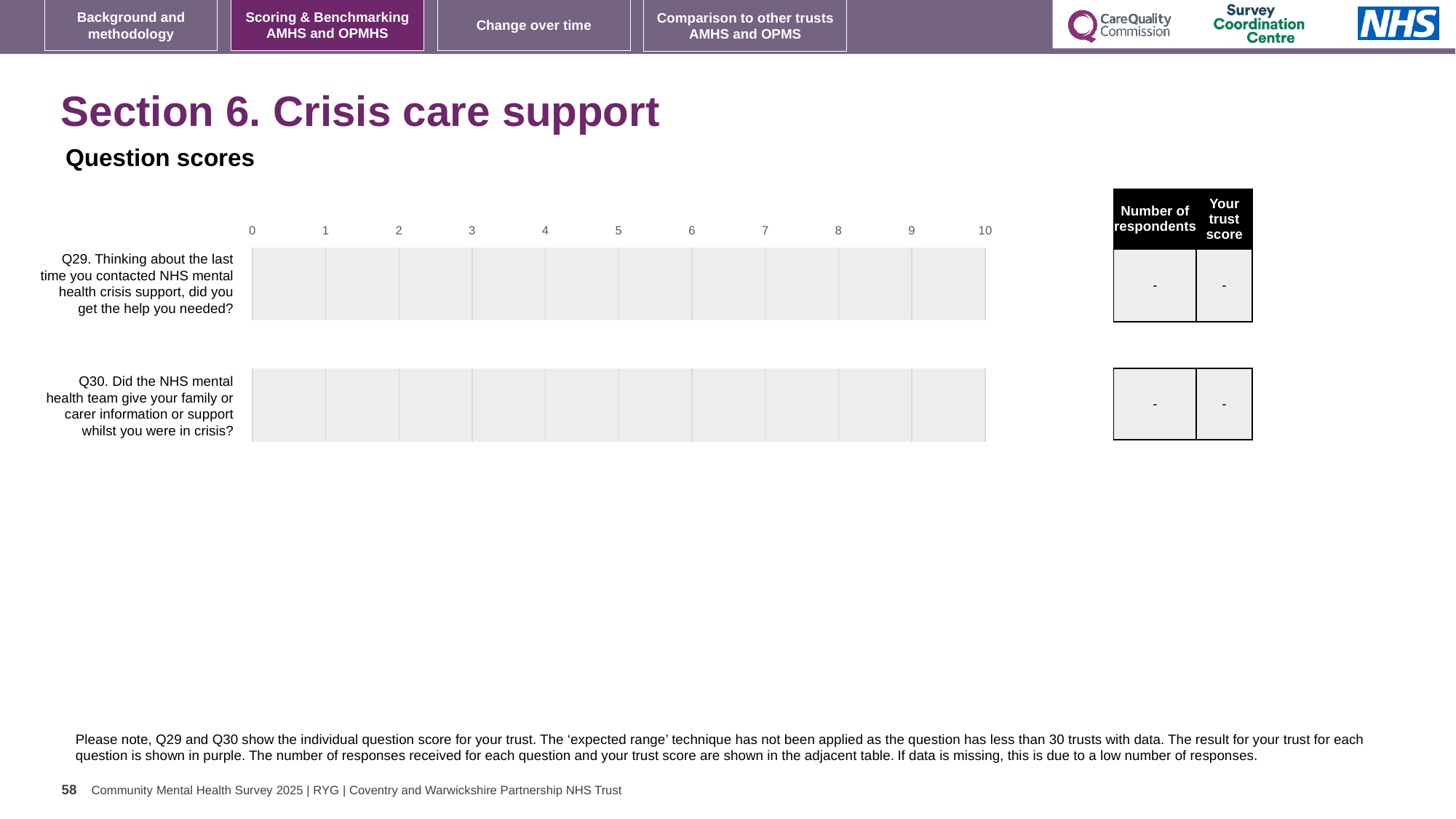
What kind of chart is shown on the slide? bar chart Are any bars plotted on the chart for Q29 or Q30? No What is the 'Number of respondents' value shown in the table for Q30? - What is the 'Your trust score' value shown in the table for Q29? - What is the lowest value shown on the chart's horizontal axis? 0 What is the highest value shown on the chart's horizontal axis? 10 How many questions (categories) are listed on the chart? 2